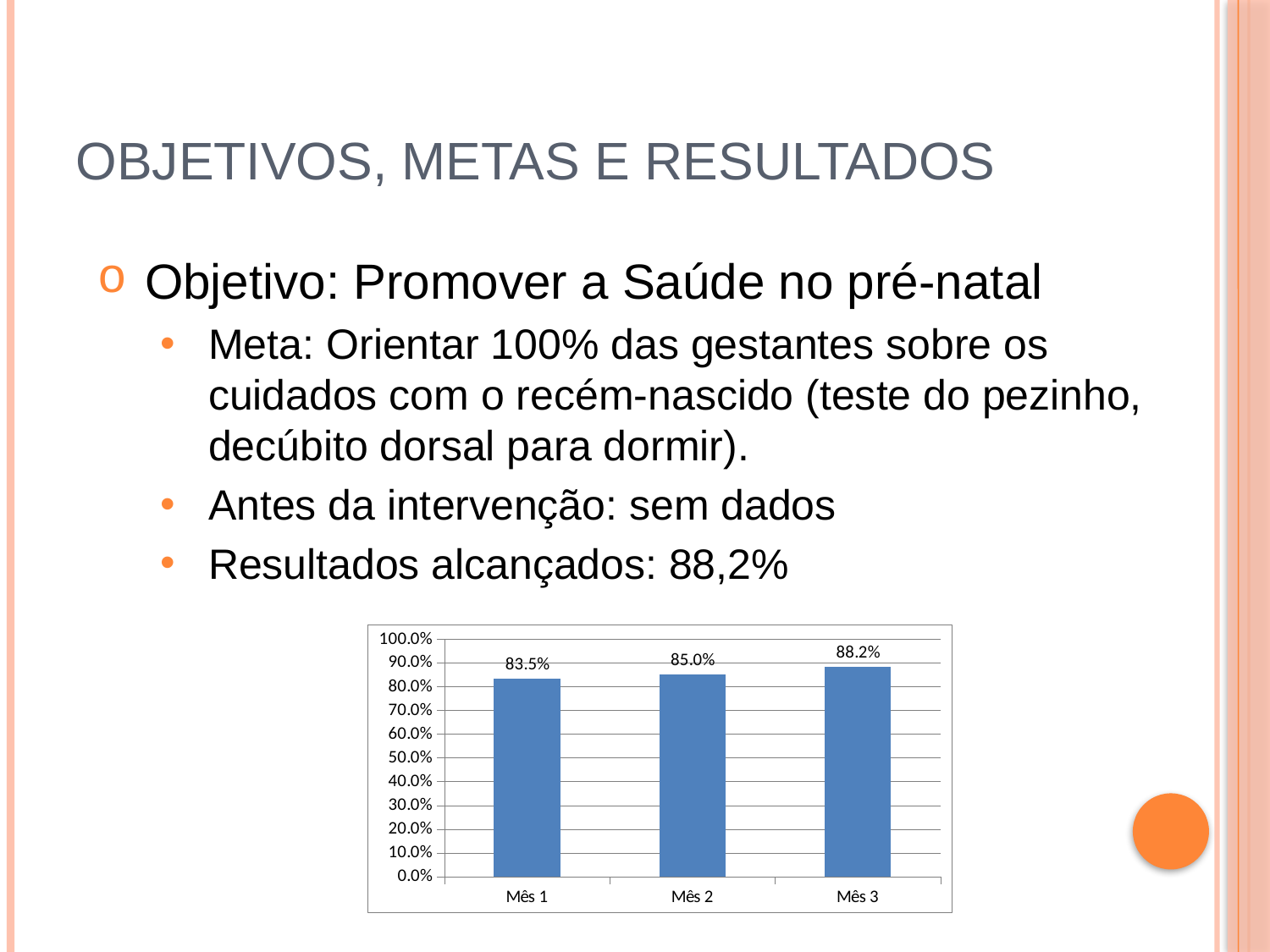
What is the value for Mês 3? 88.2% Do the values rise or fall from Mês 1 to Mês 3? rise What is the difference between the values for Mês 3 and Mês 1? 4.7% What is the difference between the values for Mês 2 and Mês 1? 1.5% What is the value for Mês 2? 85.0% What is the value for Mês 1? 83.5% Which month has the lowest value? Mês 1 Which is larger, the value for Mês 2 or the value for Mês 3? Mês 3 How many categories are shown on the x axis of the chart? 3 Is the value for Mês 1 greater or less than 90.0%? less Which month has the highest value? Mês 3 What kind of chart is shown on the slide? bar chart